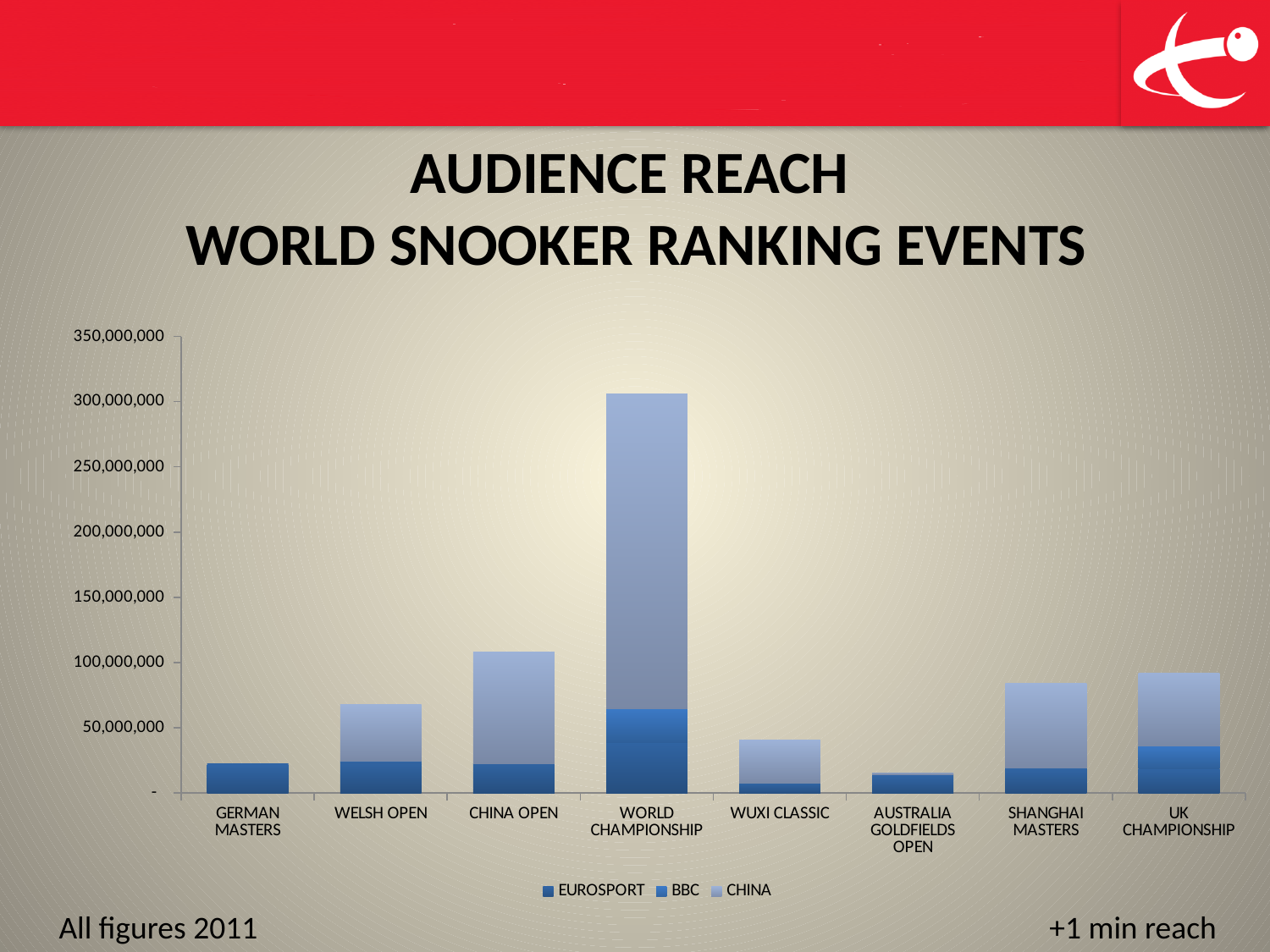
What are the three series named in the chart's legend? EUROSPORT, BBC, CHINA Which event has the larger total audience reach, the Wuxi Classic or the German Masters? Wuxi Classic Which event has the lowest total audience reach in the chart? Australia Goldfields Open Which event has the larger total audience reach, the China Open or the Welsh Open? China Open How many events (categories) are shown on the x axis of the chart? 8 Is the total audience reach for the World Championship greater or less than 250,000,000? greater Is the total audience reach for the Wuxi Classic greater or less than 50,000,000? less Is the total audience reach for the Shanghai Masters greater or less than 100,000,000? less How many series does the chart's legend list? 3 Which event has the highest total audience reach in the chart? World Championship What kind of chart is shown on the slide? Stacked bar chart